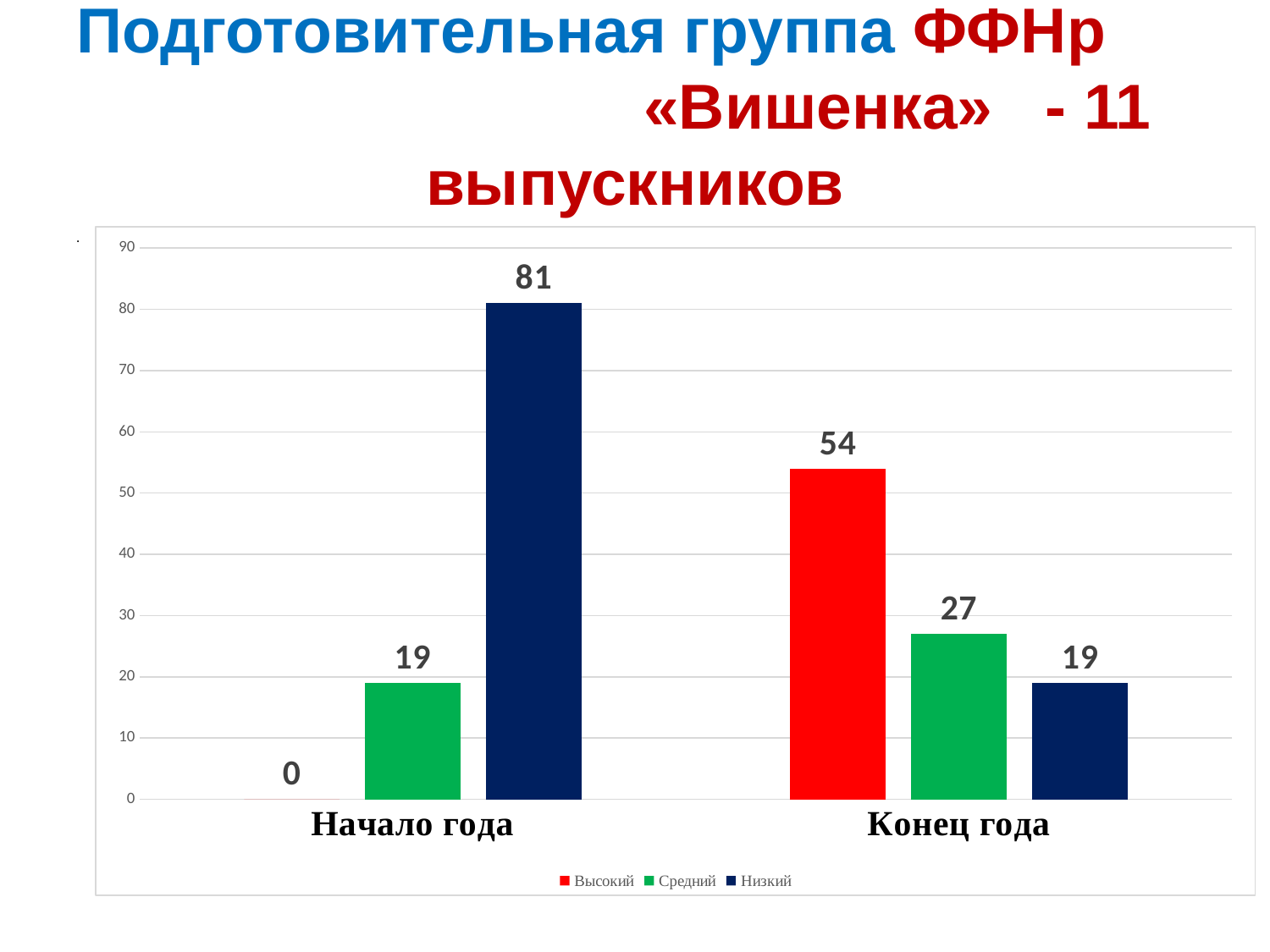
What is the value for Средний at Начало года? 19 What is the value for Высокий at Конец года? 54 What kind of chart is shown on the slide? Bar chart How many series does the legend list? 3 What colour represents the Низкий series? Dark blue Which is larger: Средний at Конец года or Средний at Начало года? Средний at Конец года How many categories are shown on the x axis? 2 Which series has the lowest value at Начало года? Высокий Which series has the highest value at Конец года? Высокий What is the difference between the Низкий values at Начало года and Конец года? 62 What is the value for Низкий at Начало года? 81 What is the value for Высокий at Начало года? 0